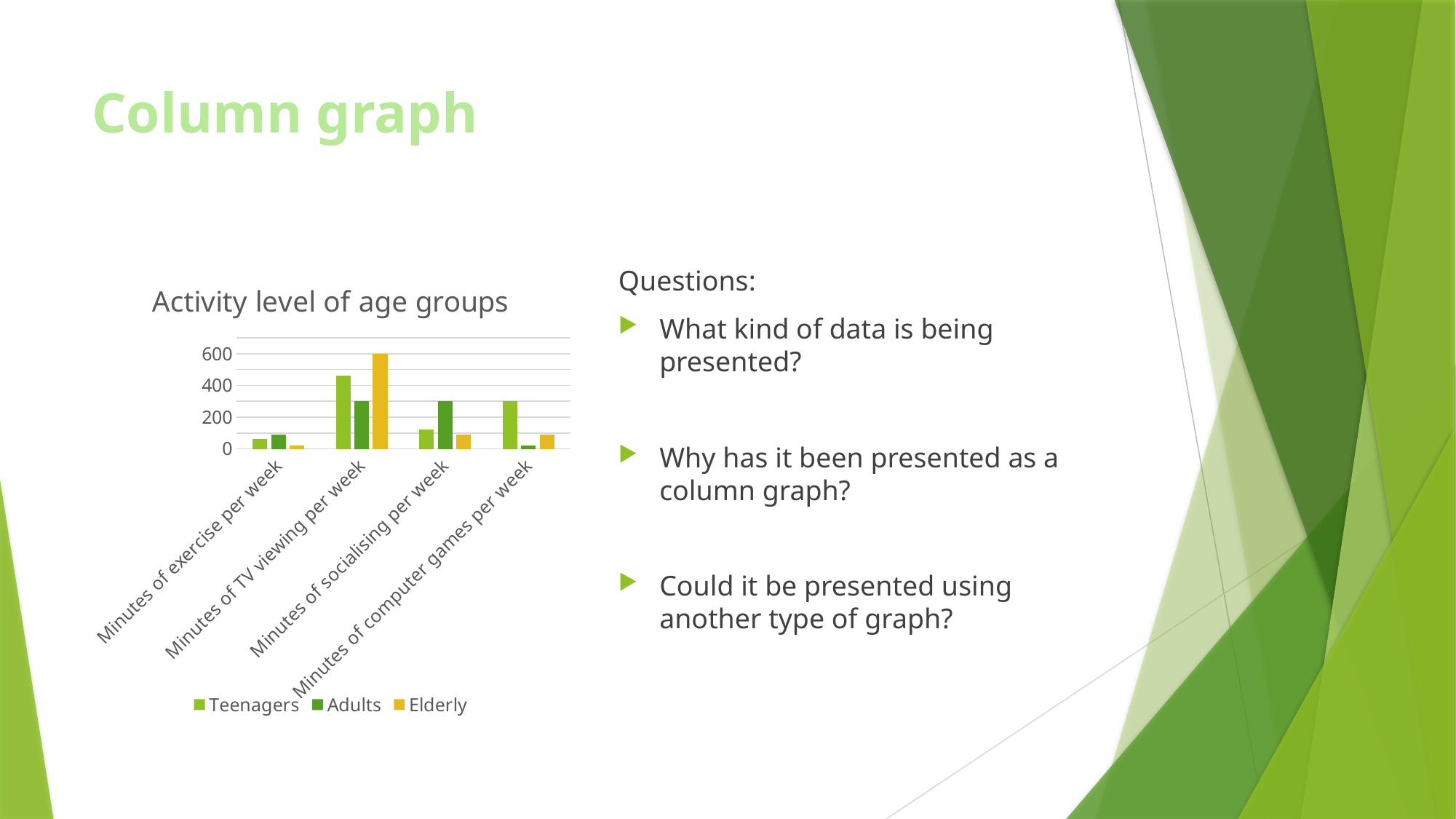
How many categories are shown on the x axis of the chart? 4 For which category is the Elderly bar the highest? Minutes of TV viewing per week For which category is the Adults bar the lowest? Minutes of computer games per week What type of chart is shown on the slide? bar chart Is the value for Adults in Minutes of TV viewing per week greater or less than 400? less Which age group has the highest value for Minutes of TV viewing per week? Elderly How many series does the chart's legend list? 3 Which is larger for Minutes of computer games per week: Teenagers or Adults? Teenagers Is the value for Teenagers in Minutes of TV viewing per week greater or less than 400? greater Which is larger for Minutes of socialising per week: Adults or Elderly? Adults What is the title of the chart? Activity level of age groups Is the value for Elderly in Minutes of exercise per week greater or less than 200? less